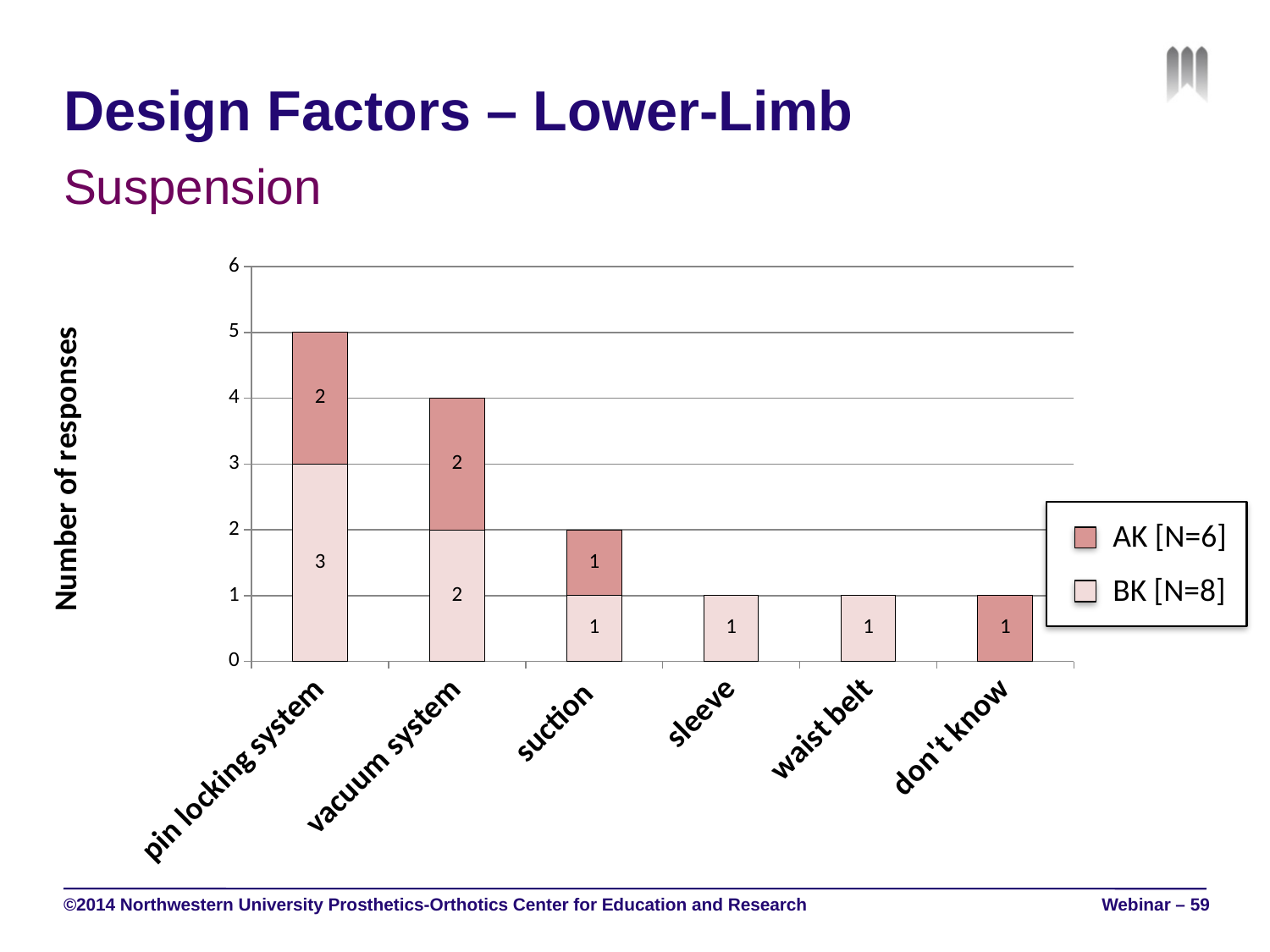
What is the BK value for pin locking system? 3 Which is larger, the total for suction or the total for sleeve? suction What is the total number of responses for vacuum system? 4 What is the total number of responses for pin locking system? 5 What is the AK value for vacuum system? 2 How many series does the legend list? 2 How many suspension categories are shown on the x axis? 6 Which category has the highest total number of responses? pin locking system What kind of chart is shown on the slide? stacked bar chart What is the difference between the BK values for pin locking system and vacuum system? 1 Which series does the 'don't know' bar belong to? AK [N=6] What is the AK value for suction? 1